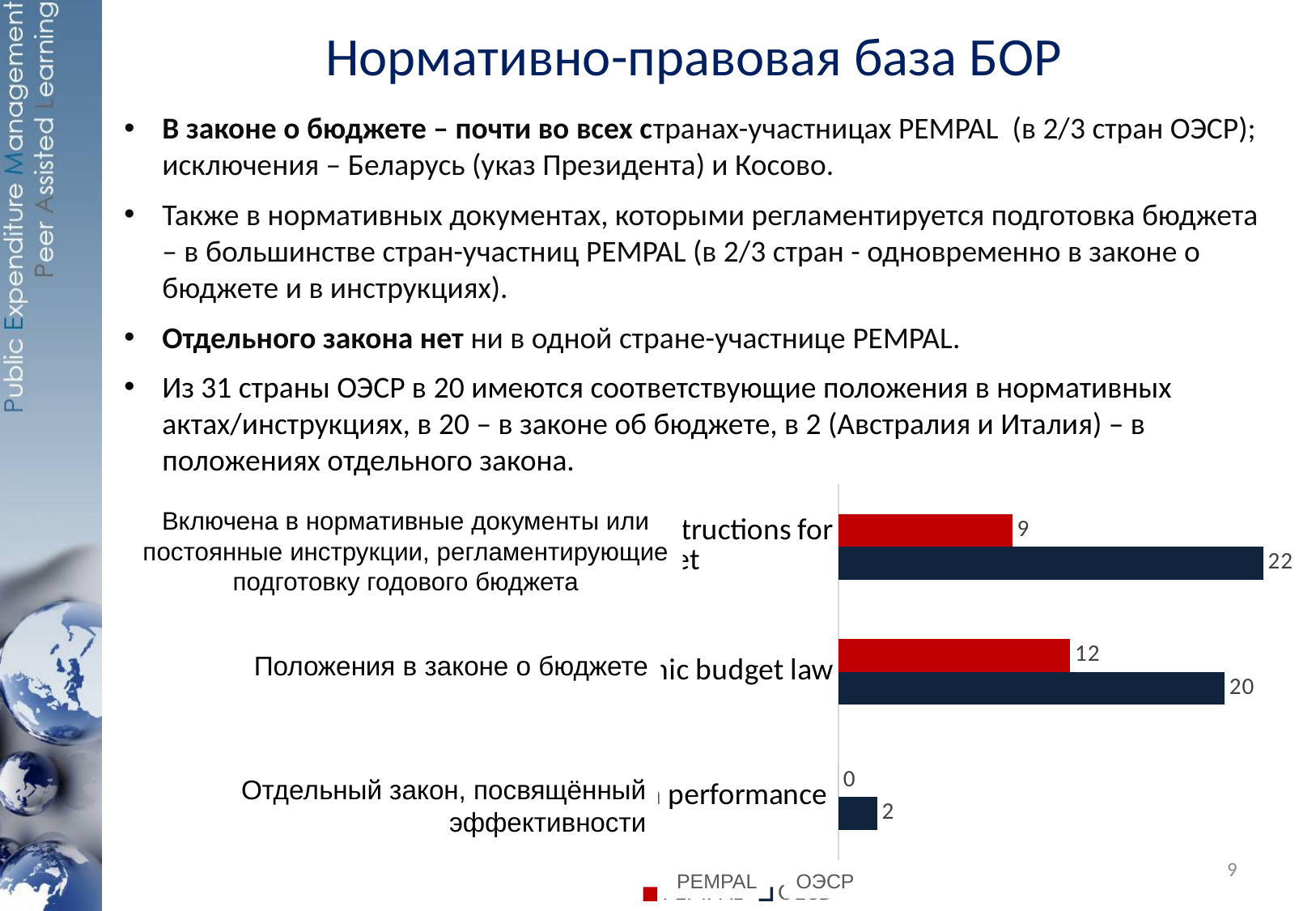
What is the PEMPAL value for "Положения в законе о бюджете"? 12 What is the PEMPAL value for "Отдельный закон, посвящённый эффективности"? 0 Which category has the lowest PEMPAL value? Отдельный закон, посвящённый эффективности How many series does the chart legend list? 2 Which category has the highest ОЭСР value? Включена в нормативные документы или постоянные инструкции, регламентирующие подготовку годового бюджета What is the difference between the ОЭСР and PEMPAL values for "Включена в нормативные документы или постоянные инструкции, регламентирующие подготовку годового бюджета"? 13 How many categories are shown in the chart? 3 What is the ОЭСР value for "Включена в нормативные документы или постоянные инструкции, регламентирующие подготовку годового бюджета"? 22 For "Положения в законе о бюджете", which series has the larger value, PEMPAL or ОЭСР? ОЭСР What is the ОЭСР value for "Положения в законе о бюджете"? 20 What kind of chart is shown on the slide? bar chart Which colour represents the PEMPAL series in the chart? red